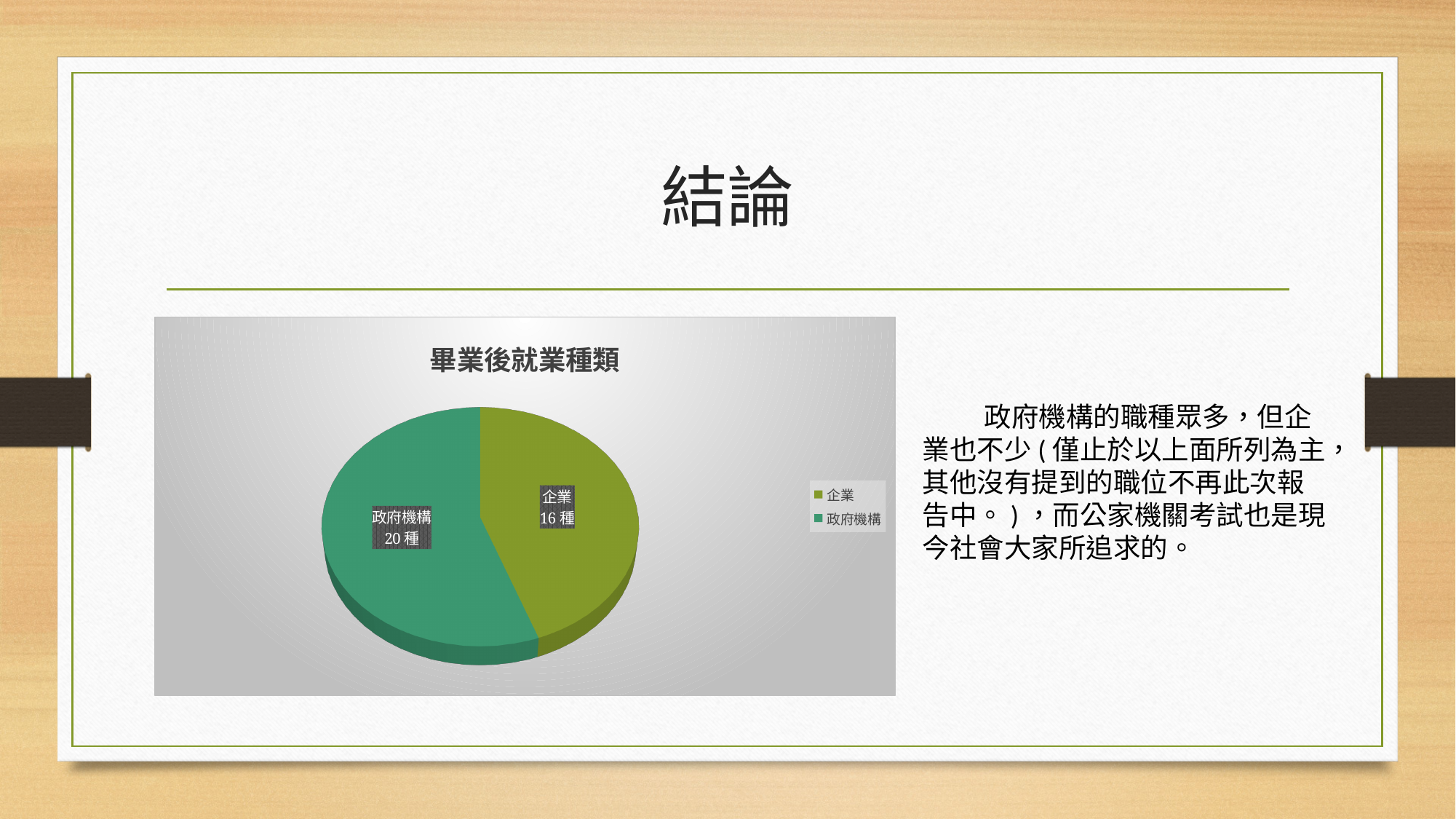
Which is larger, the value for 企業 or the value for 政府機構? 政府機構 What is the value shown for 政府機構? 20 種 How many slices does the pie chart have? 2 Which legend entry is shown in the teal green colour? 政府機構 What kind of chart is shown on the slide? pie chart What is the difference between the value for 政府機構 and the value for 企業? 4 種 What is the value shown for 企業? 16 種 Which category has the smallest slice of the pie? 企業 What is the total of the two values shown in the pie chart? 36 種 What is the title of the chart? 畢業後就業種類 How many entries does the chart legend list? 2 Which category has the largest slice of the pie? 政府機構